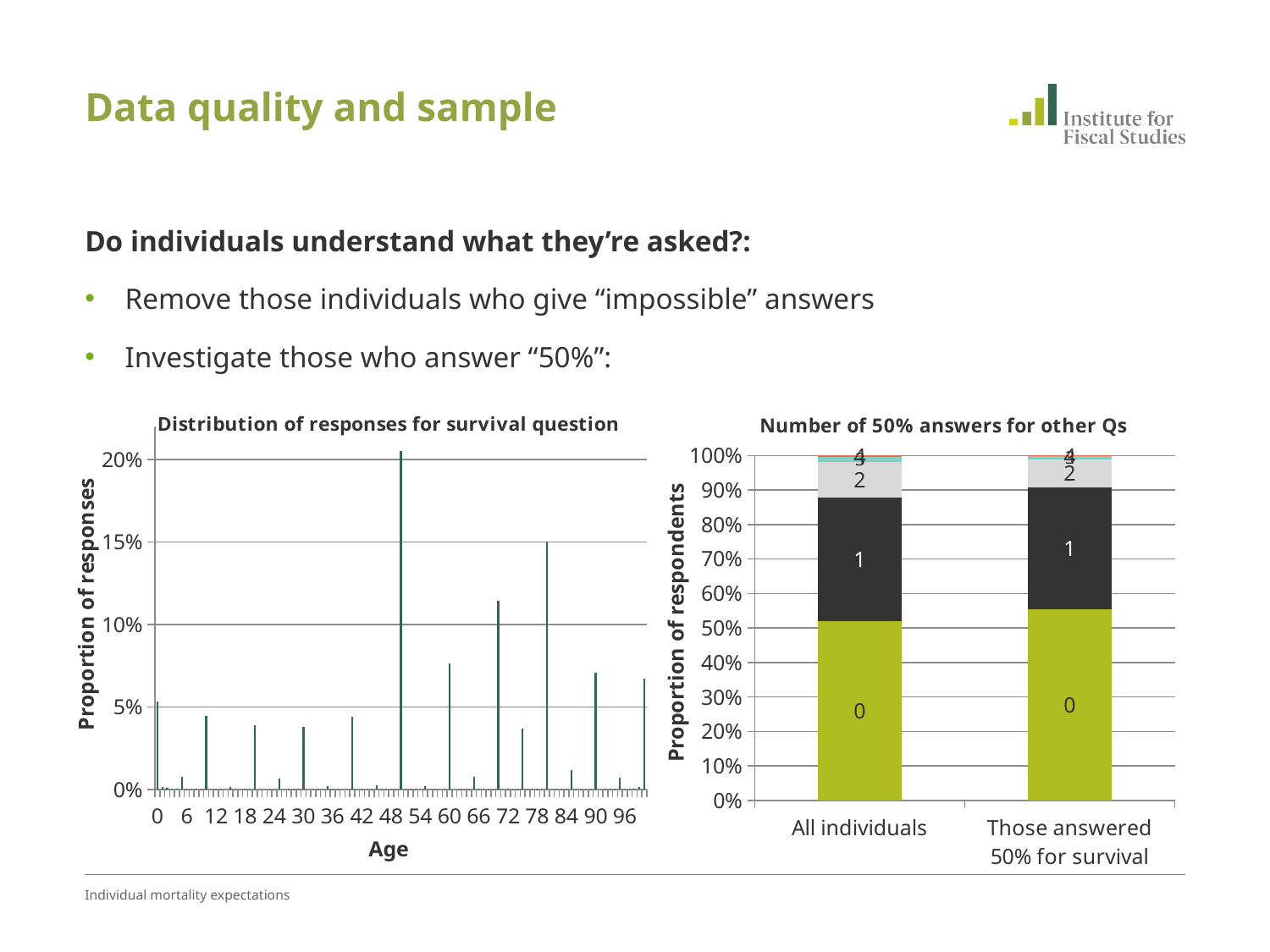
In the left chart, 'Distribution of responses for survival question', is the bar at age 60 greater or less than 5%? greater In the right chart, 'Number of 50% answers for other Qs', is the top of the '1' segment for 'All individuals' greater or less than 90%? less In the right chart, 'Number of 50% answers for other Qs', which category has the larger share for segment '0': 'All individuals' or 'Those answered 50% for survival'? Those answered 50% for survival What kind of chart is the right chart, 'Number of 50% answers for other Qs'? stacked bar chart In the left chart, 'Distribution of responses for survival question', what is the x-axis title? Age In the right chart, 'Number of 50% answers for other Qs', how many categories are shown on the x axis? 2 In the right chart, 'Number of 50% answers for other Qs', is the top of the '0' segment for 'Those answered 50% for survival' greater or less than 50%? greater What kind of chart is the left chart, 'Distribution of responses for survival question'? bar chart In the right chart, 'Number of 50% answers for other Qs', what is the y-axis title? Proportion of respondents In the right chart, 'Number of 50% answers for other Qs', which segment takes up the largest share of the 'All individuals' bar? 0